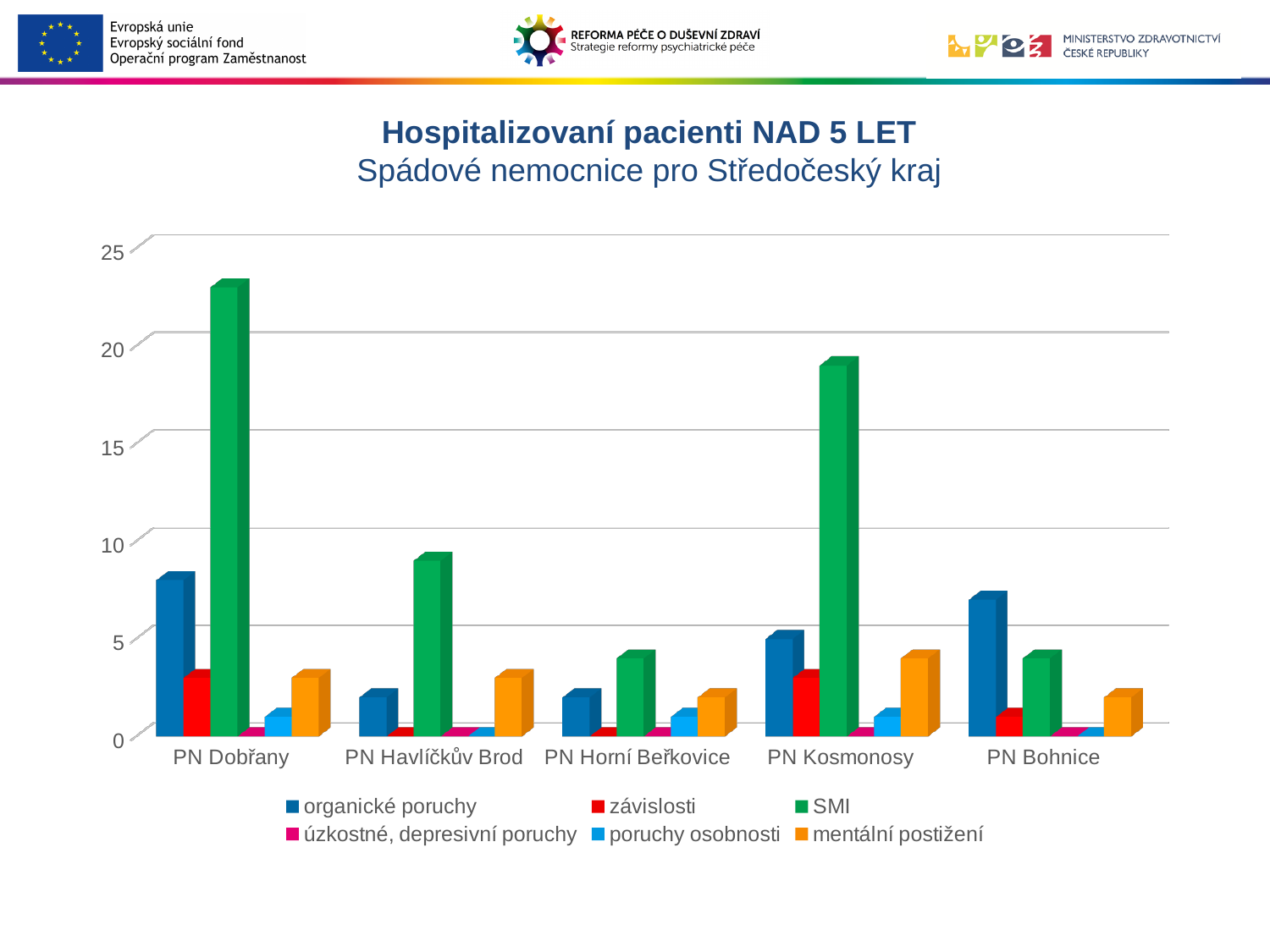
What is the title of the chart on the slide? Hospitalizovaní pacienti NAD 5 LET – Spádové nemocnice pro Středočeský kraj Is the SMI value for PN Havlíčkův Brod greater or less than 10? less What kind of chart is shown on the slide? bar chart Is the value for organické poruchy at PN Dobřany greater or less than 5? greater Is the SMI value for PN Kosmonosy greater or less than 15? greater How many series does the legend list? 6 How many hospitals (categories) are shown on the x axis? 5 Which hospital has the highest value for SMI? PN Dobřany Which series has the highest value at PN Kosmonosy? SMI Which is larger: the organické poruchy value for PN Dobřany or for PN Havlíčkův Brod? PN Dobřany Which is larger: the SMI value for PN Dobřany or for PN Kosmonosy? PN Dobřany